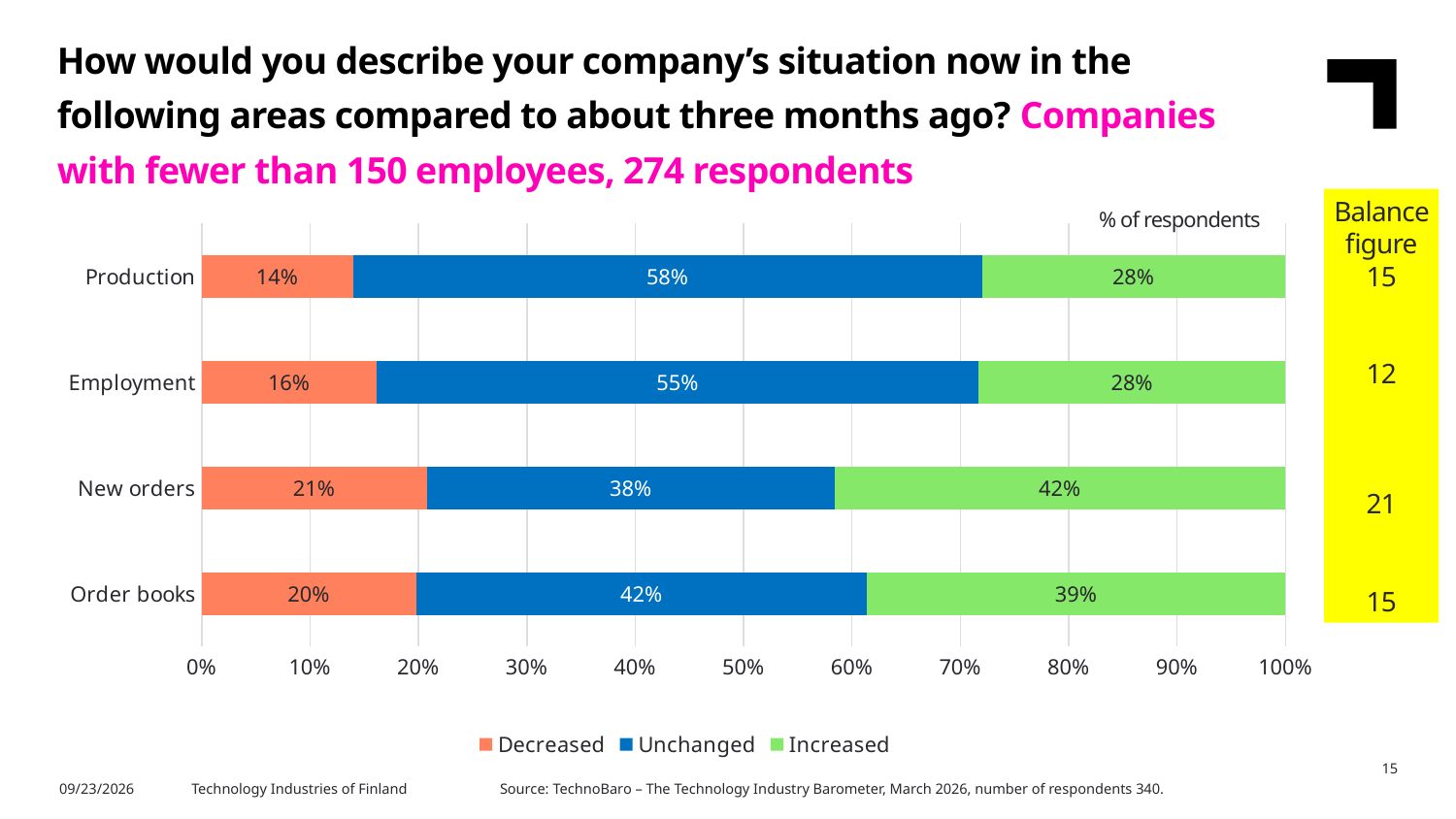
What is the difference between the Unchanged share for Production and the Unchanged share for New orders? 20 percentage points Which category has the highest share of respondents reporting a decrease? New orders What percentage of respondents reported that Production was unchanged? 58% Which category has the lowest share of respondents reporting an increase? Production and Employment (both 28%) Which is larger: the Increased share for Order books or the Increased share for Employment? Order books What percentage of respondents reported that Order books decreased? 20% What kind of chart is shown on the slide? Stacked bar chart What percentage of respondents reported that New orders increased? 42% How many categories are shown on the chart? 4 How many series does the legend list? 3 What is the balance figure shown for New orders? 21 Which series is shown in green in the legend? Increased